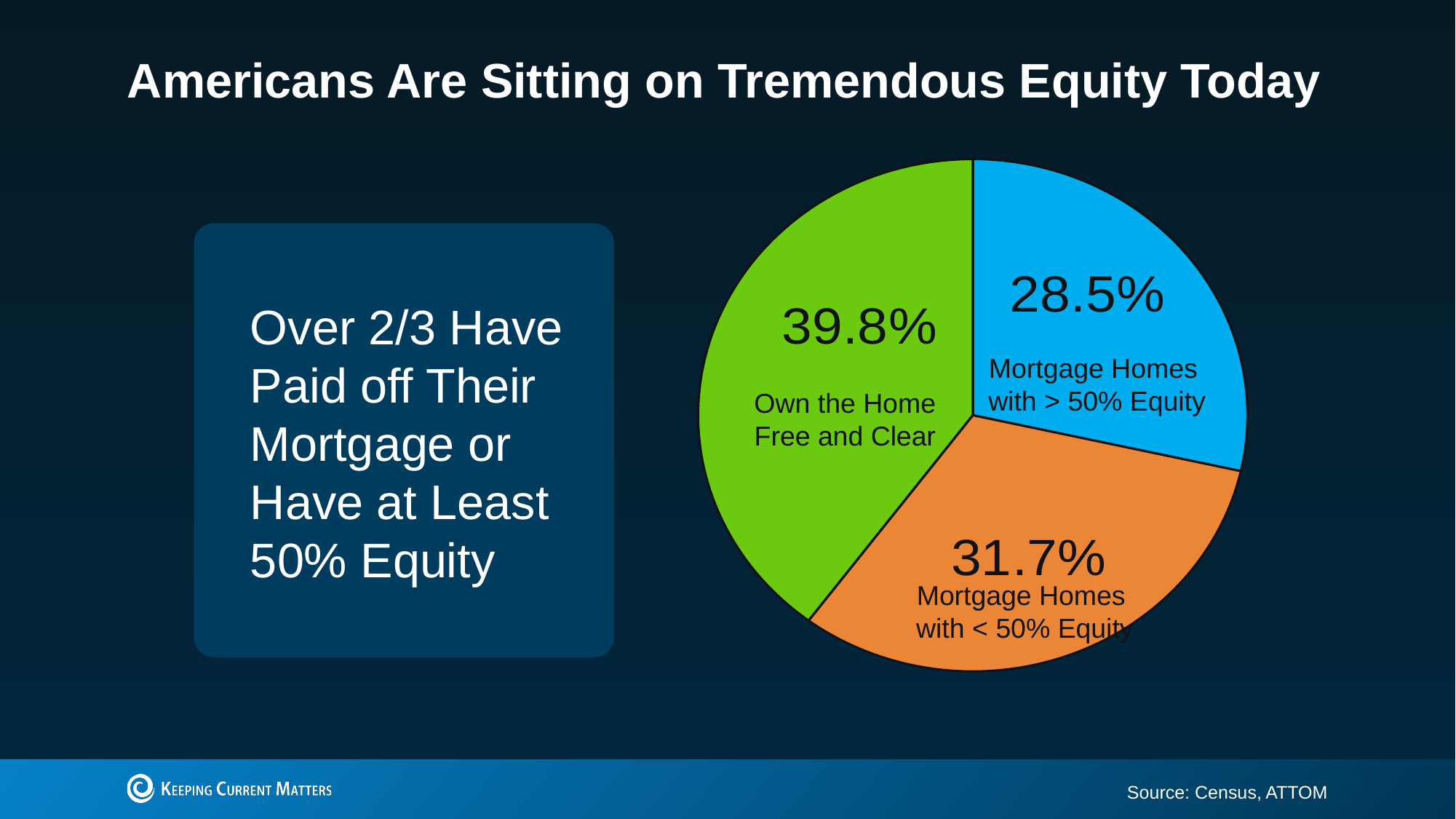
Which is larger: the "Mortgage Homes with < 50% Equity" slice or the "Mortgage Homes with > 50% Equity" slice? Mortgage Homes with < 50% Equity What share of the pie is labelled "Mortgage Homes with > 50% Equity"? 28.5% What is the difference between the "Mortgage Homes with < 50% Equity" slice and the "Mortgage Homes with > 50% Equity" slice? 3.2% What share of the pie is labelled "Mortgage Homes with < 50% Equity"? 31.7% Which slice of the pie is the smallest? Mortgage Homes with > 50% Equity What colour is the "Own the Home Free and Clear" slice? Green What kind of chart is shown on the slide? Pie chart How many slices does the pie chart have? 3 What share of the pie is labelled "Own the Home Free and Clear"? 39.8% Which slice of the pie is the largest? Own the Home Free and Clear What is the difference between the "Own the Home Free and Clear" slice and the "Mortgage Homes with > 50% Equity" slice? 11.3% What is the title of the slide containing the pie chart? Americans Are Sitting on Tremendous Equity Today